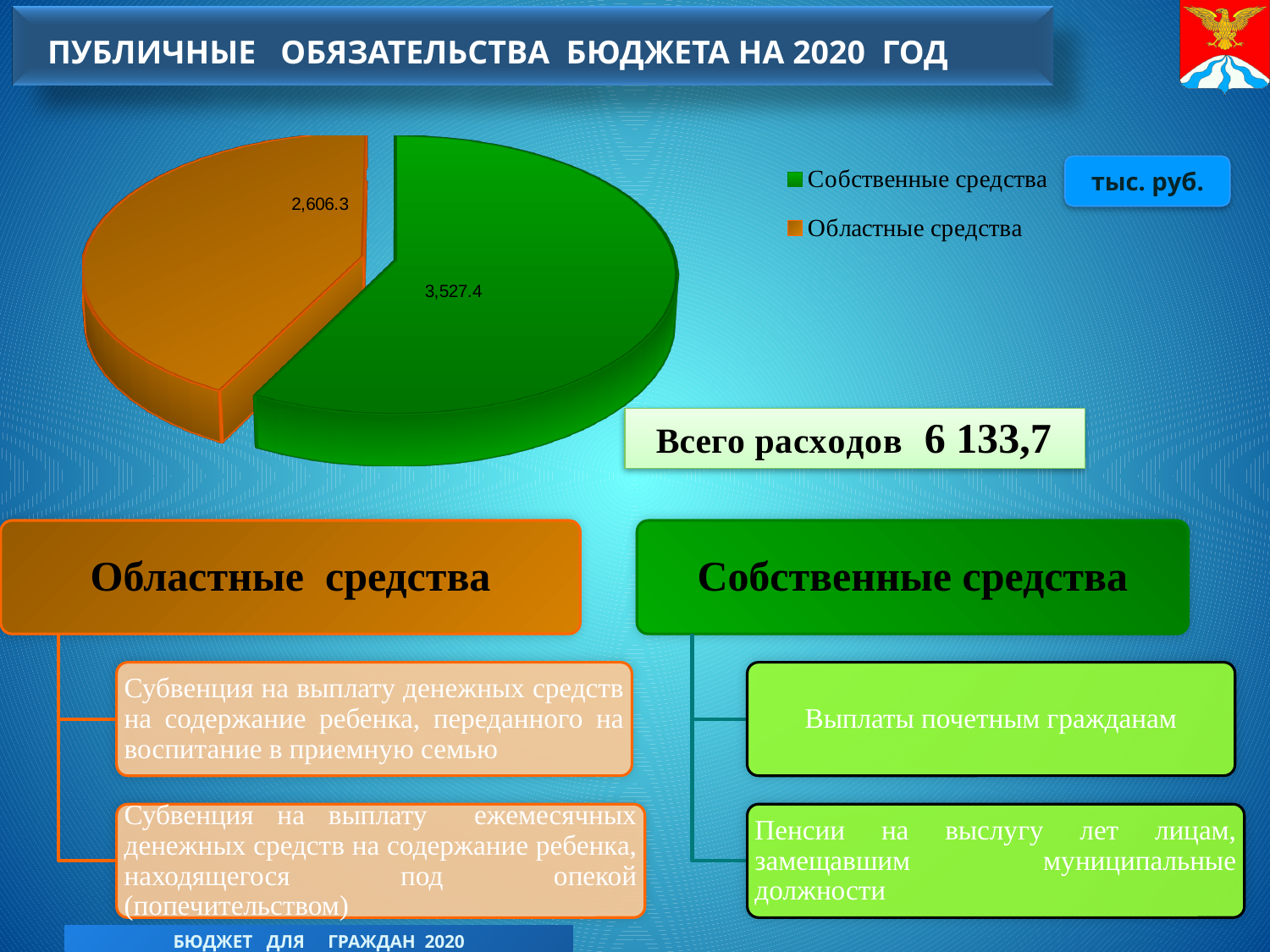
What unit is indicated for the values in the pie chart? тыс. руб. What is the value for Областные средства in the pie chart? 2,606.3 What is the difference between the values for Собственные средства and Областные средства? 921.1 What is the value for Собственные средства in the pie chart? 3,527.4 What colour is the Областные средства slice in the pie chart? orange Which is larger: Собственные средства or Областные средства? Собственные средства Which slice of the pie chart is the smallest? Областные средства What type of chart is shown on the slide? pie chart What is the total of the two slices in the pie chart, as shown on the slide (Всего расходов)? 6 133,7 How many slices does the pie chart have? 2 How many series does the legend list? 2 Which slice of the pie chart is the largest? Собственные средства